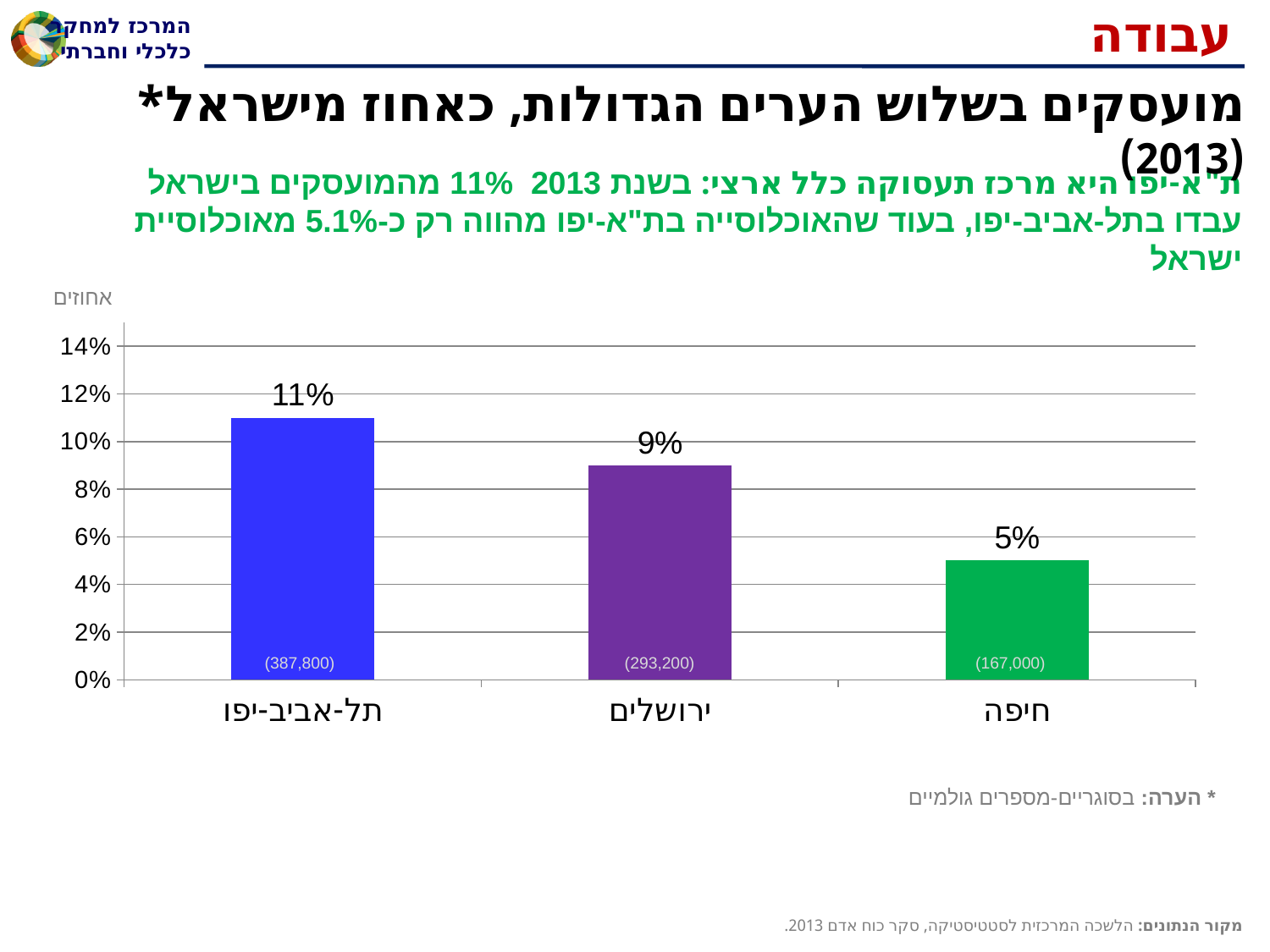
What is the label on the vertical axis of the chart? אחוזים What is the difference between the values for תל-אביב-יפו and חיפה? 6% What is the value for ירושלים? 9% Which city has the lowest value? חיפה Which city has the highest value? תל-אביב-יפו Which is larger, the value for ירושלים or the value for חיפה? ירושלים How many cities are shown in the chart? 3 What absolute number is printed inside the bar for חיפה? (167,000) What absolute number is printed inside the bar for תל-אביב-יפו? (387,800) What kind of chart is shown on the slide? bar chart What is the value for תל-אביב-יפו? 11% What is the value for חיפה? 5%